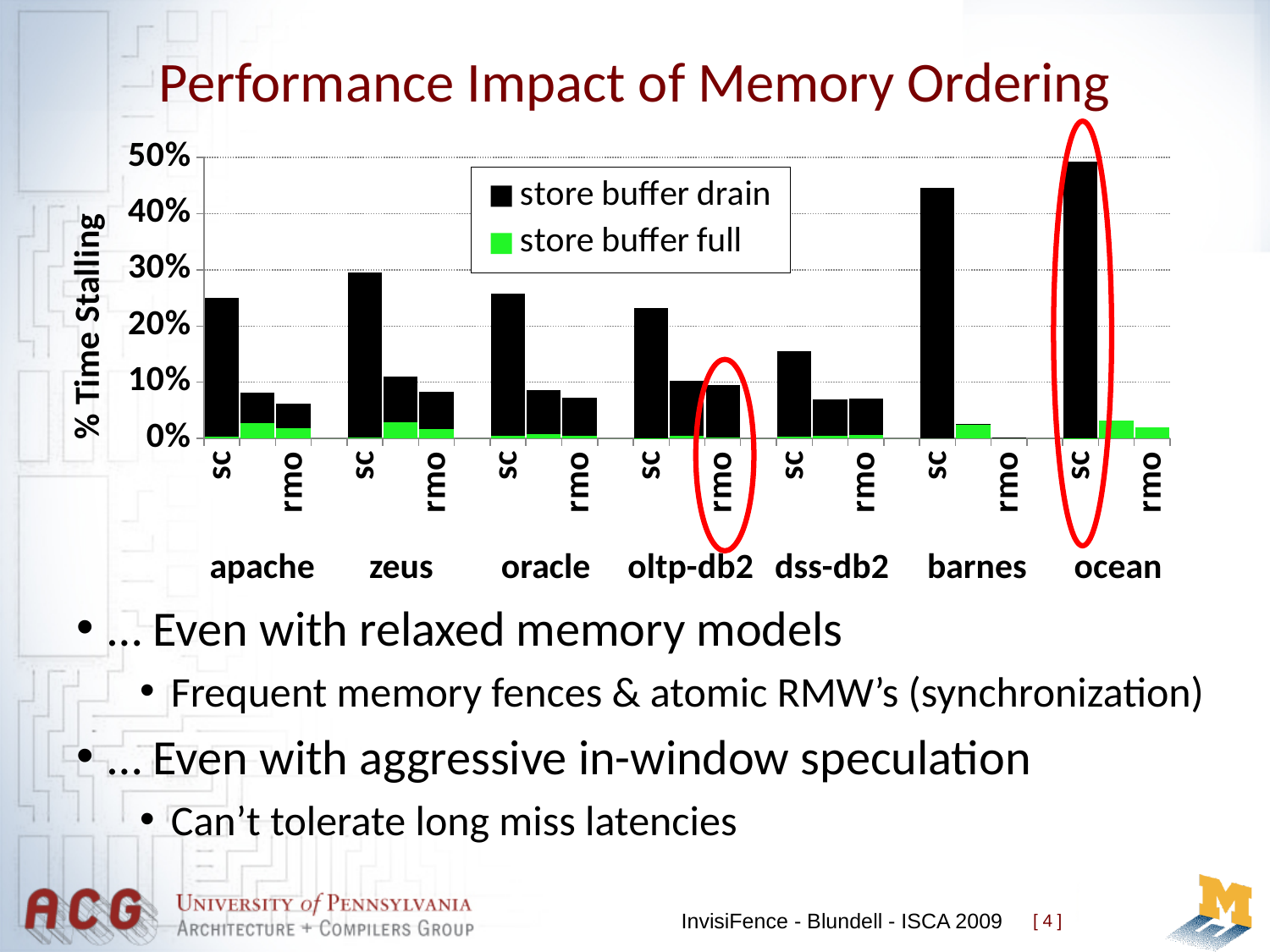
Is the total stalling time for the apache sc bar greater or less than 20%? greater What are the two series named in the legend? store buffer drain, store buffer full How many series does the legend list? 2 Is the total stalling time for the apache rmo bar greater or less than 10%? less Which is larger, the barnes sc bar or the apache sc bar? barnes sc Is the total stalling time for the barnes sc bar greater or less than 40%? greater Which bar is the tallest in the chart? ocean sc Within the oracle group, which is larger, the sc bar or the rmo bar? sc How many benchmark groups are shown along the x axis? 7 What kind of chart is shown on the slide? bar chart What is the label of the y axis? % Time Stalling